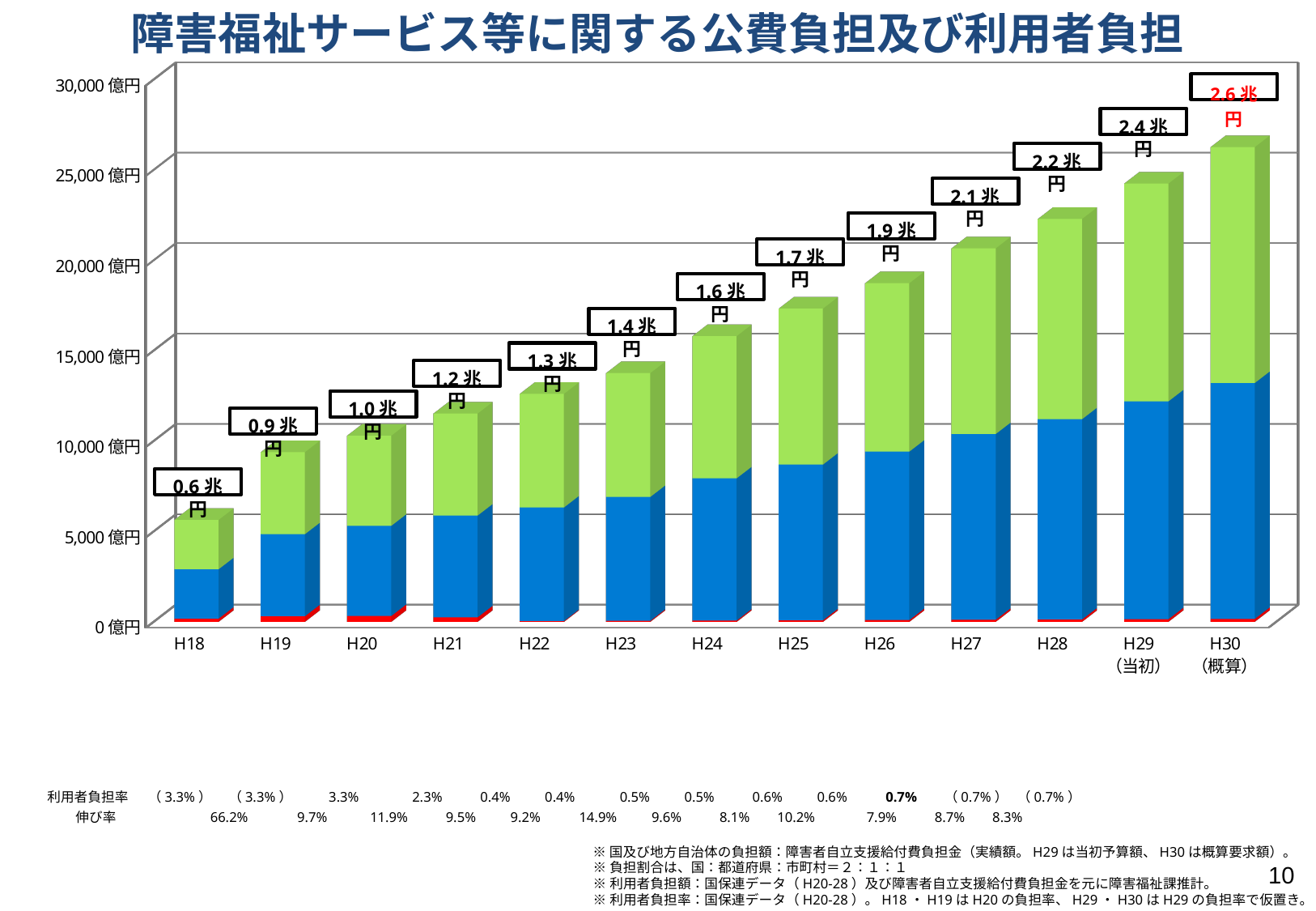
What kind of chart is shown on the slide? stacked bar chart Which has the larger labelled total, H22 or H24? H24 Is the total bar for H28 greater or less than 20,000億円? greater What total value is labelled above the H18 bar? 0.6兆円 Which year has the lowest total bar? H18 Which year has the highest total bar? H30（概算） What total value is labelled above the H30（概算） bar? 2.6兆円 Is the total bar for H18 greater or less than 10,000億円? less What total value is labelled above the H24 bar? 1.6兆円 How many years (categories) are shown on the x axis? 13 What is the difference between the labelled totals for H30（概算） and H18? 2.0兆円 Do the total bar values rise or fall from H18 to H30? rise